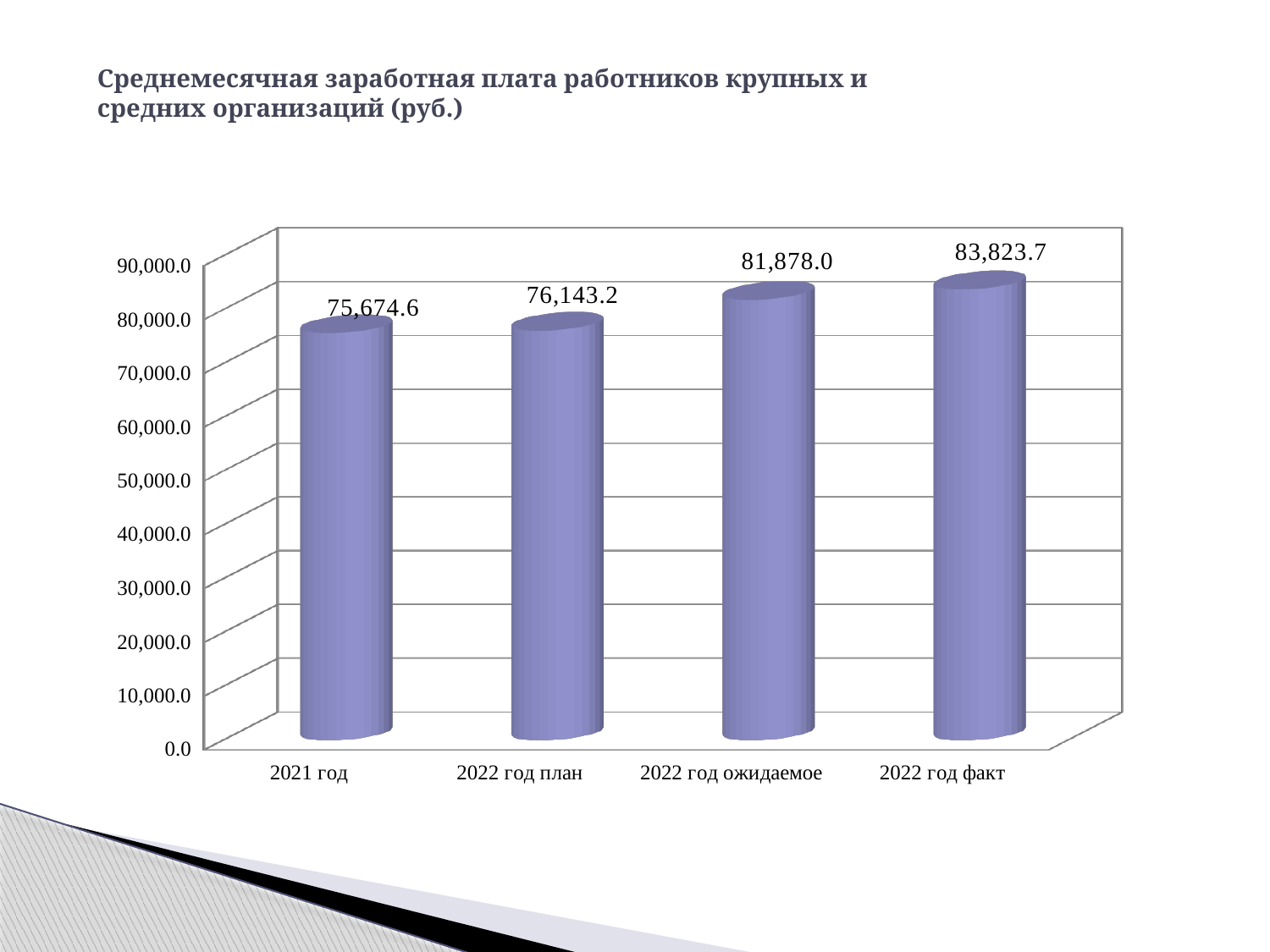
Do the values rise or fall from left to right along the x axis? Rise What is the value for 2022 год план? 76,143.2 What kind of chart is shown on the slide? Bar chart What is the difference between the values for 2022 год ожидаемое and 2022 год план? 5,734.8 How many categories are shown on the x axis? 4 What is the value for 2021 год? 75,674.6 What is the difference between the values for 2022 год факт and 2021 год? 8,149.1 Which category has the lowest value? 2021 год Which is larger, the value for 2022 год ожидаемое or the value for 2022 год план? 2022 год ожидаемое What is the value for 2022 год ожидаемое? 81,878.0 What is the value for 2022 год факт? 83,823.7 Which category has the highest value? 2022 год факт